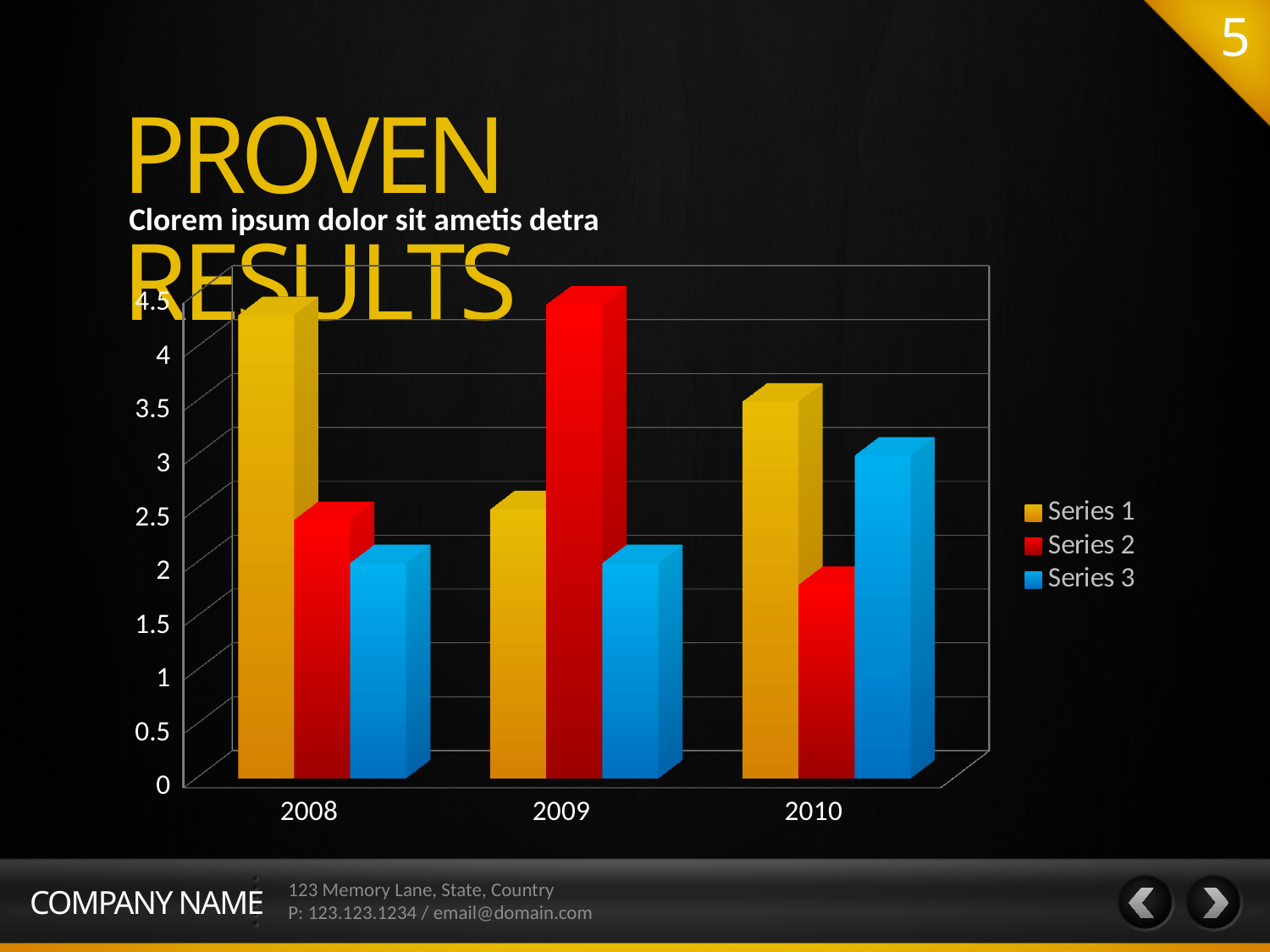
Which series has the highest value in 2009? Series 2 In which year is Series 2 at its lowest? 2010 Is the value for Series 2 in 2009 greater or less than 4? greater Is the value for Series 1 in 2008 greater or less than 4? greater Is the value for Series 1 in 2009 greater or less than 3? less In which year is Series 1 at its highest? 2008 In 2010, which is larger: Series 3 or Series 2? Series 3 How many categories are shown on the x axis? 3 How many series does the legend list? 3 What kind of chart is shown on the slide? bar chart What colour represents Series 2 in the legend? red